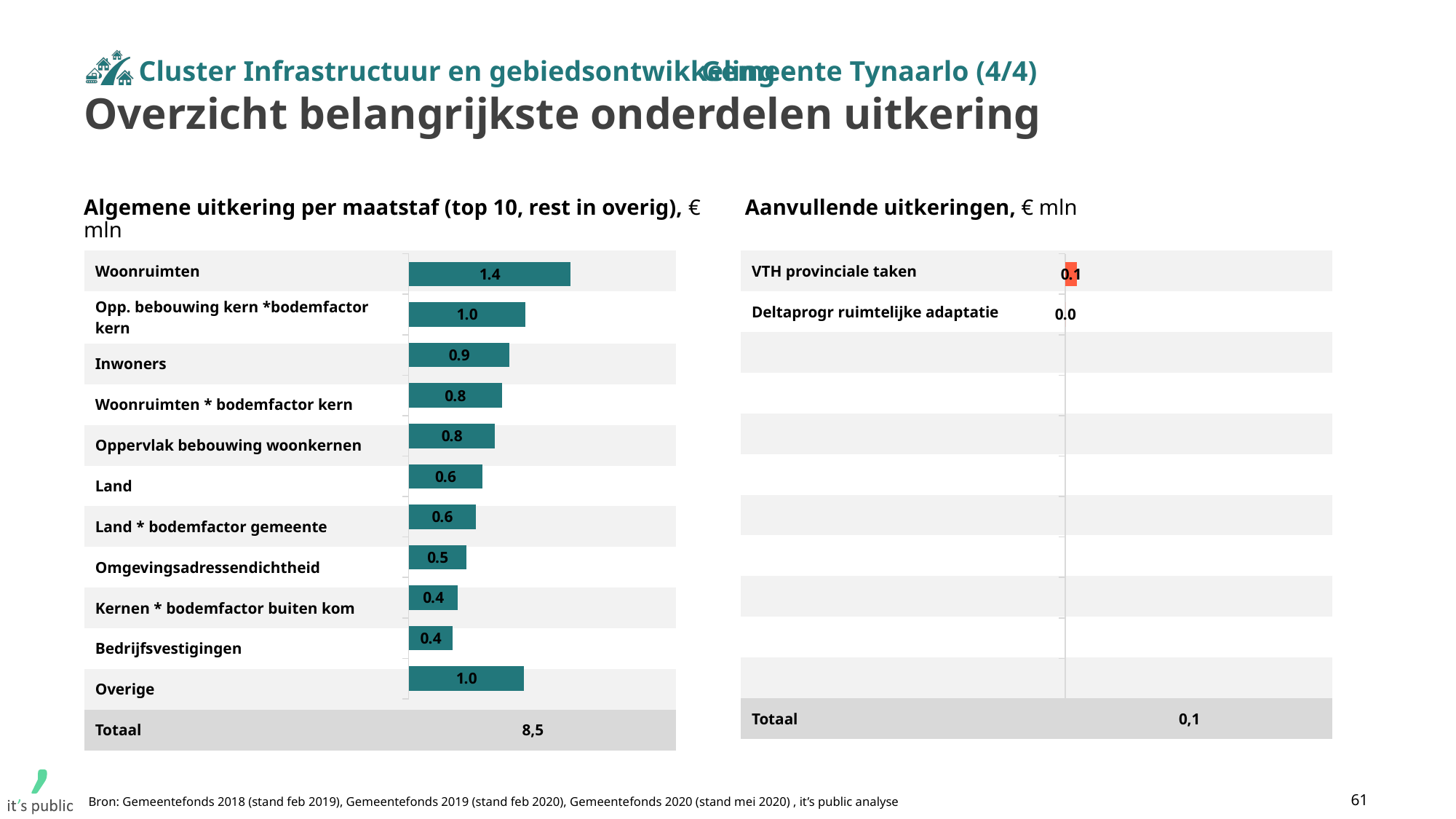
In the 'Algemene uitkering per maatstaf' chart, which is larger: Land or Overige? Overige What type of chart is the 'Algemene uitkering per maatstaf' chart? Bar chart In the 'Algemene uitkering per maatstaf' chart, which category has the highest value? Woonruimten In the 'Aanvullende uitkeringen' chart, what is the value for VTH provinciale taken? 0.1 In the 'Algemene uitkering per maatstaf' chart, what is the value for Woonruimten? 1.4 What is the total shown for the 'Algemene uitkering per maatstaf' chart? 8,5 How many categories (bars) are shown in the 'Algemene uitkering per maatstaf' chart? 11 What unit is stated in the title of the 'Aanvullende uitkeringen' chart? € mln In the 'Aanvullende uitkeringen' chart, what is the value for Deltaprogr ruimtelijke adaptatie? 0.0 In the 'Algemene uitkering per maatstaf' chart, what is the value for Inwoners? 0.9 In the 'Algemene uitkering per maatstaf' chart, what is the difference between Woonruimten and Inwoners? 0.5 In the 'Algemene uitkering per maatstaf' chart, what is the value for Omgevingsadressendichtheid? 0.5